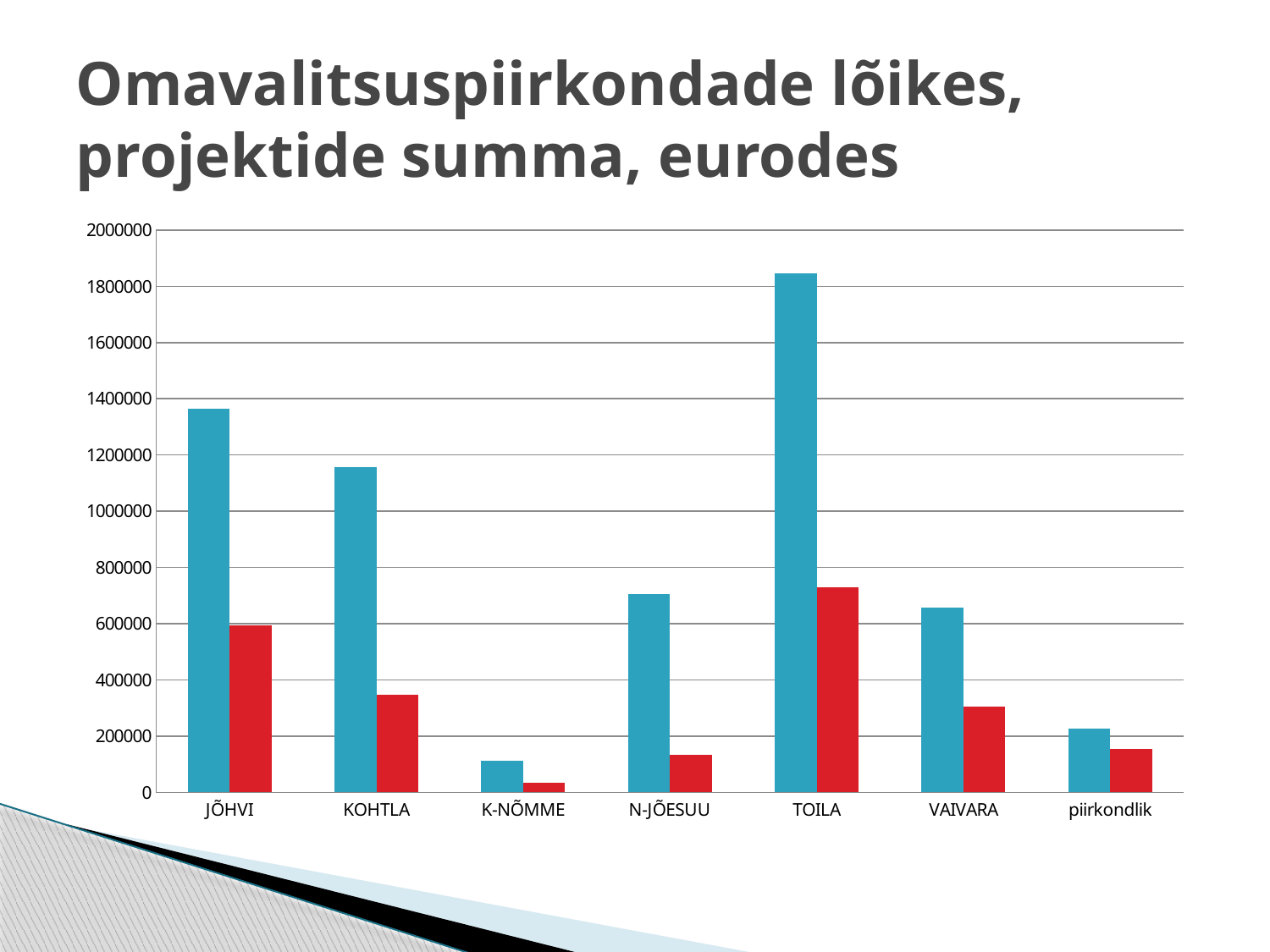
Which category has the shortest red bar? K-NÕMME Which category has the shortest blue bar? K-NÕMME What is the title of the chart on the slide? Omavalitsuspiirkondade lõikes, projektide summa, eurodes Is the blue bar for KOHTLA greater or less than 1000000? greater How many categories are shown on the x axis? 7 Is the red bar for KOHTLA greater or less than 400000? less Is the blue bar for TOILA greater or less than 1800000? greater Which category has the tallest red bar? TOILA How many data series (bar colours) are plotted for each category? 2 What kind of chart is shown on the slide? bar chart Which category has the tallest blue bar? TOILA Which has the larger blue bar, JÕHVI or KOHTLA? JÕHVI